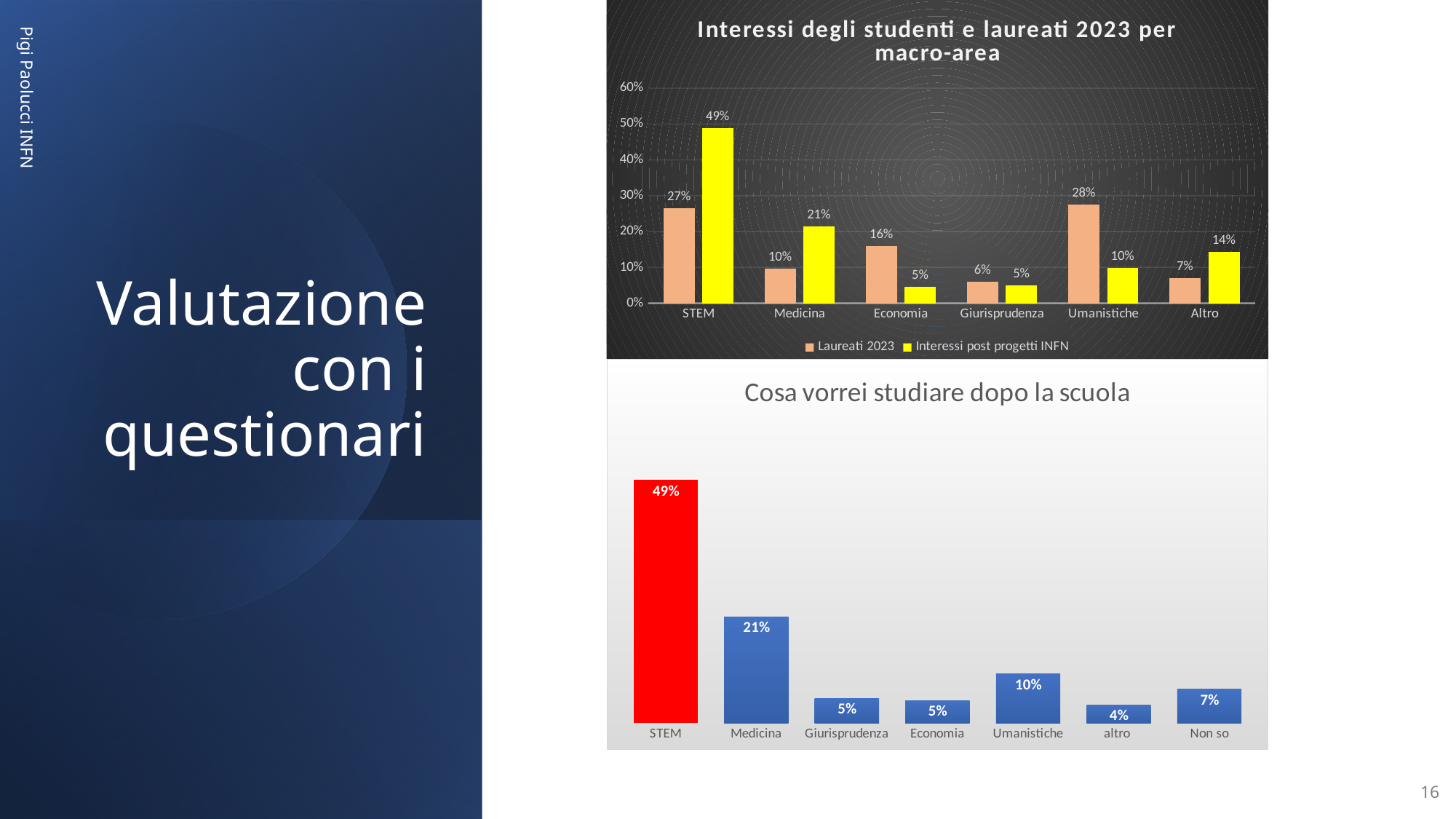
How many series does the legend of the chart 'Interessi degli studenti e laureati 2023 per macro-area' list? 2 What type of chart is 'Cosa vorrei studiare dopo la scuola'? Bar chart In the chart 'Interessi degli studenti e laureati 2023 per macro-area', which is larger for Economia: 'Laureati 2023' or 'Interessi post progetti INFN'? Laureati 2023 In the chart 'Cosa vorrei studiare dopo la scuola', which category has the lowest value? altro In the chart 'Interessi degli studenti e laureati 2023 per macro-area', what is the value for STEM in the 'Interessi post progetti INFN' series? 49% In the chart 'Interessi degli studenti e laureati 2023 per macro-area', what is the value for Umanistiche in the 'Laureati 2023' series? 28% In the chart 'Cosa vorrei studiare dopo la scuola', what is the value for Medicina? 21% How many categories are shown on the x axis of the chart 'Interessi degli studenti e laureati 2023 per macro-area'? 6 In the chart 'Interessi degli studenti e laureati 2023 per macro-area', which category has the highest value in the 'Laureati 2023' series? Umanistiche In the chart 'Cosa vorrei studiare dopo la scuola', what is the difference between STEM and Umanistiche? 39% In the chart 'Interessi degli studenti e laureati 2023 per macro-area', what is the difference between the 'Interessi post progetti INFN' and 'Laureati 2023' values for STEM? 22% How many categories are shown in the chart 'Cosa vorrei studiare dopo la scuola'? 7